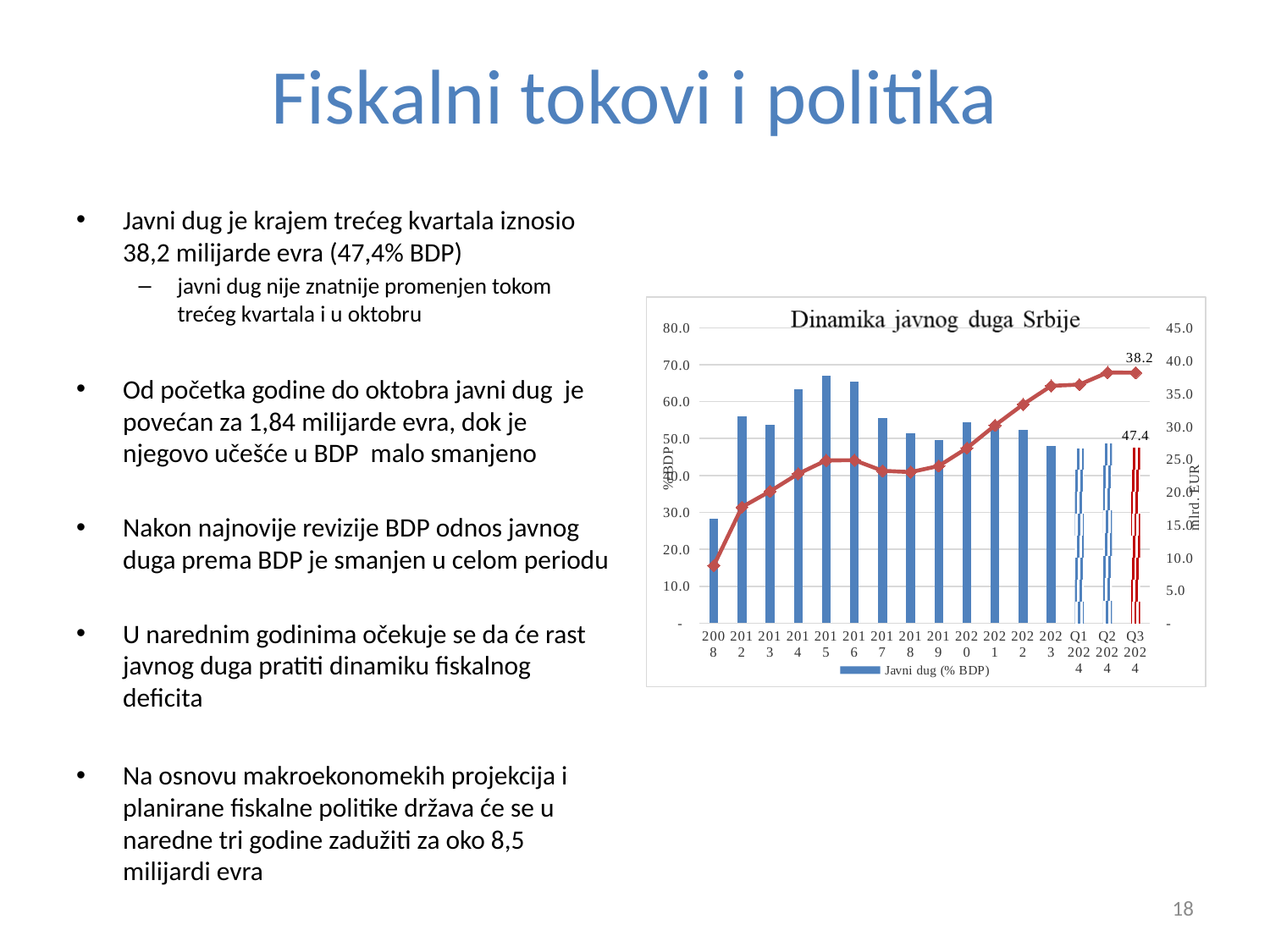
Is the bar for 2008 greater or less than 40.0 on the left axis? less Is the bar for 2014 taller or shorter than the bar for 2017? taller What series name is shown in the legend of the chart? Javni dug (% BDP) Is the bar for 2015 greater or less than 60.0 on the left axis? greater What type of chart is used to show 'Javni dug (% BDP)' in the chart? bar chart How many categories are shown on the x axis of the chart? 16 What is the title of the chart on the slide? Dinamika javnog duga Srbije Which year has the tallest bar in the chart? 2015 What is the value of the data label on the bar for Q3 2024 in the chart? 47.4 What is the value of the data label on the line for Q3 2024 in the chart? 38.2 Does the line series in the chart generally rise or fall from 2008 to Q3 2024? rise Which year has the shortest bar in the chart? 2008